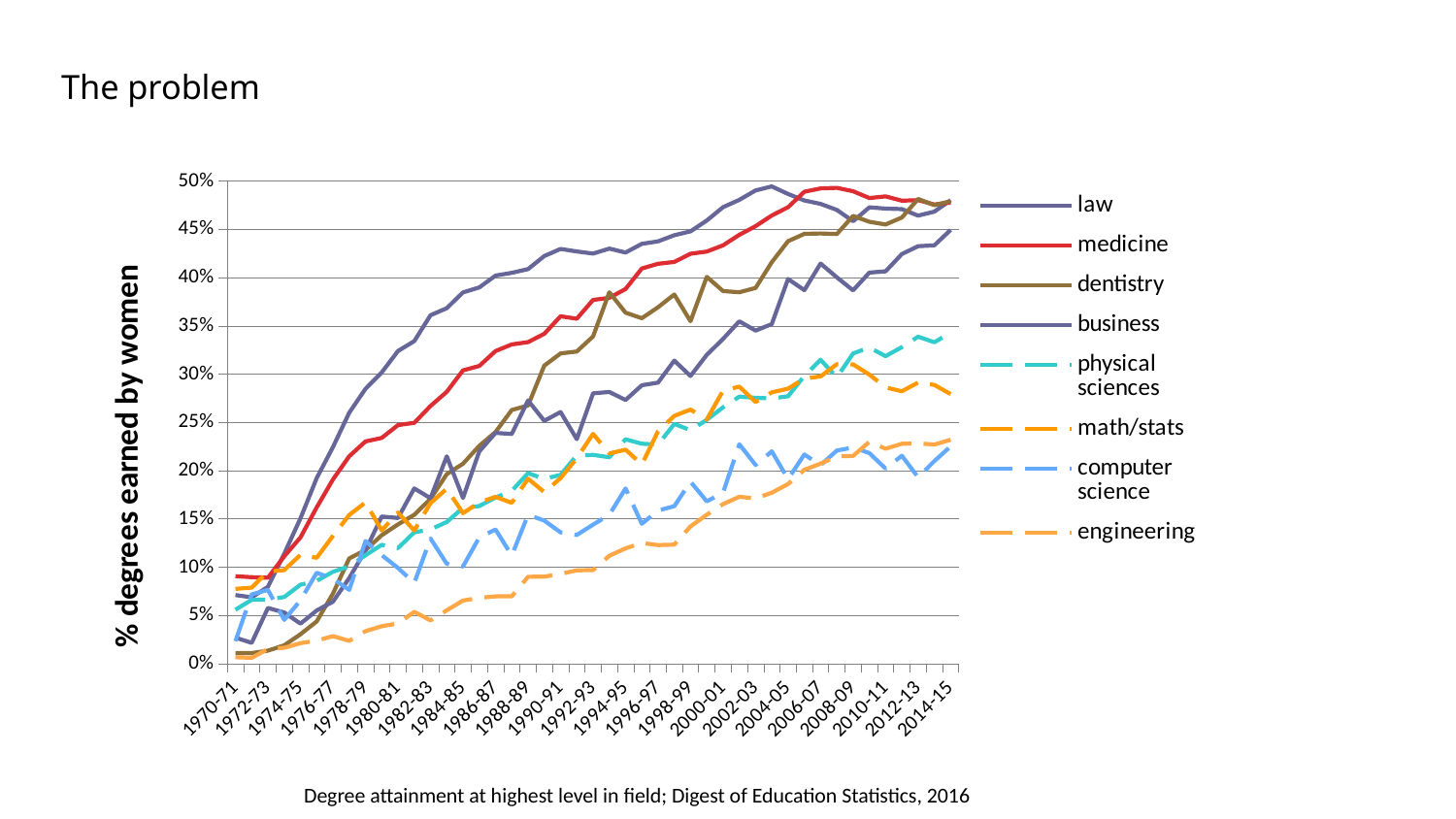
Is the value for business in 1970-71 greater or less than 5%? less In 2014-15, which is larger, the value for medicine or the value for engineering? medicine What kind of chart is shown on the slide? line chart Which series has the highest value in 1990-91? law Is the value for medicine in 2014-15 greater or less than 45%? greater Is the value for engineering in 2014-15 greater or less than 20%? greater Does the value for law generally rise or fall from 1970-71 to 2014-15? rise How many series does the legend list? 8 Which series are drawn with dashed lines? physical sciences, math/stats, computer science, engineering Which series has the lowest value in 1990-91? engineering What is the title of the y axis? % degrees earned by women